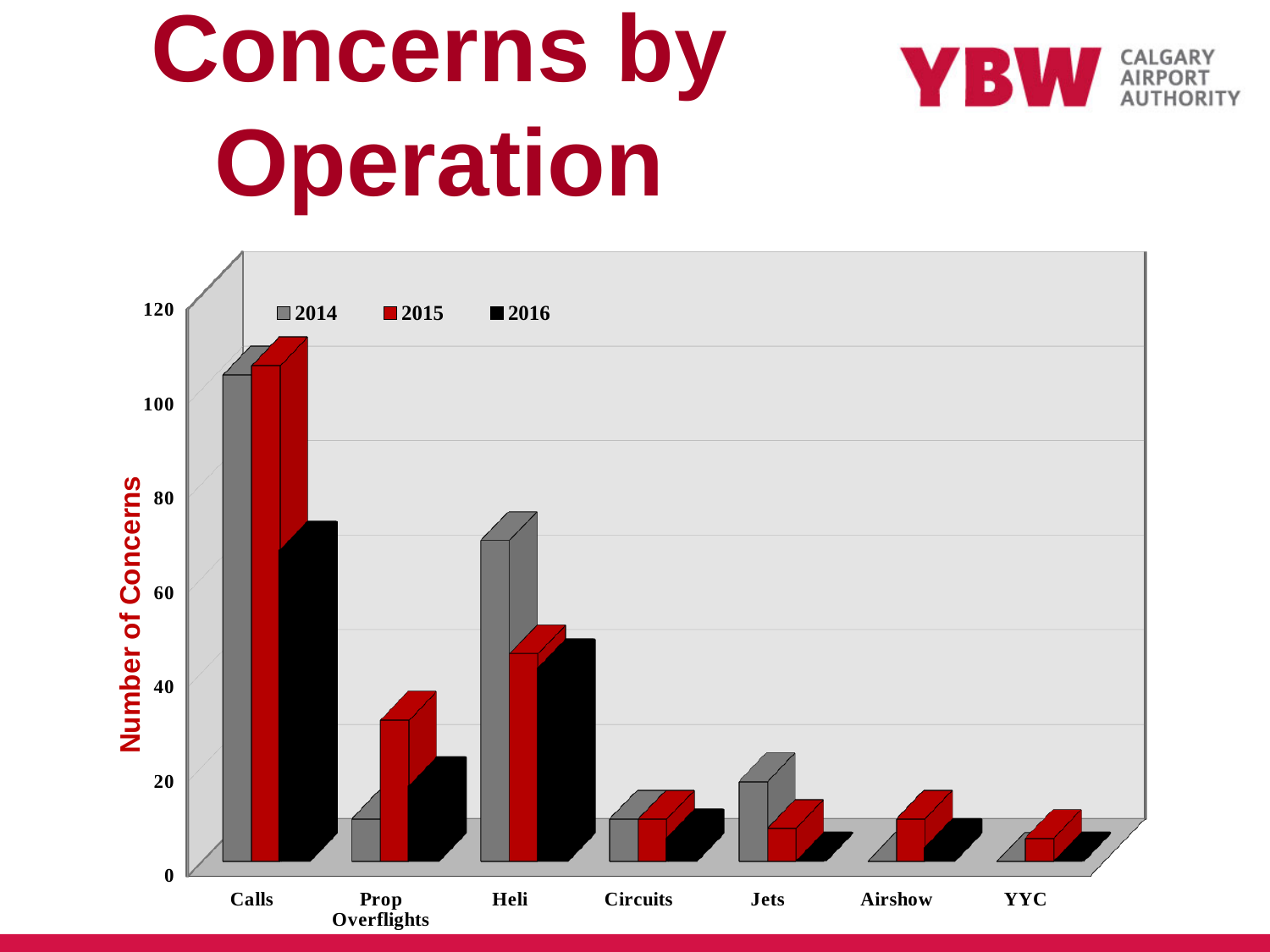
What is the title of the y axis? Number of Concerns How many series does the legend list? 3 Which category has the highest number of concerns for 2015? Calls Which is larger, the 2016 value for Calls or the 2016 value for Heli? Calls How many operation categories are shown on the x axis? 7 What kind of chart is shown on the slide? bar chart Is the value for Prop Overflights in 2015 greater or less than 40? less For Prop Overflights, which year has the highest number of concerns? 2015 Is the value for Circuits in 2014 greater or less than 20? less For Heli, which year has the larger value, 2014 or 2015? 2014 Is the value for Calls in 2014 greater or less than 100? greater